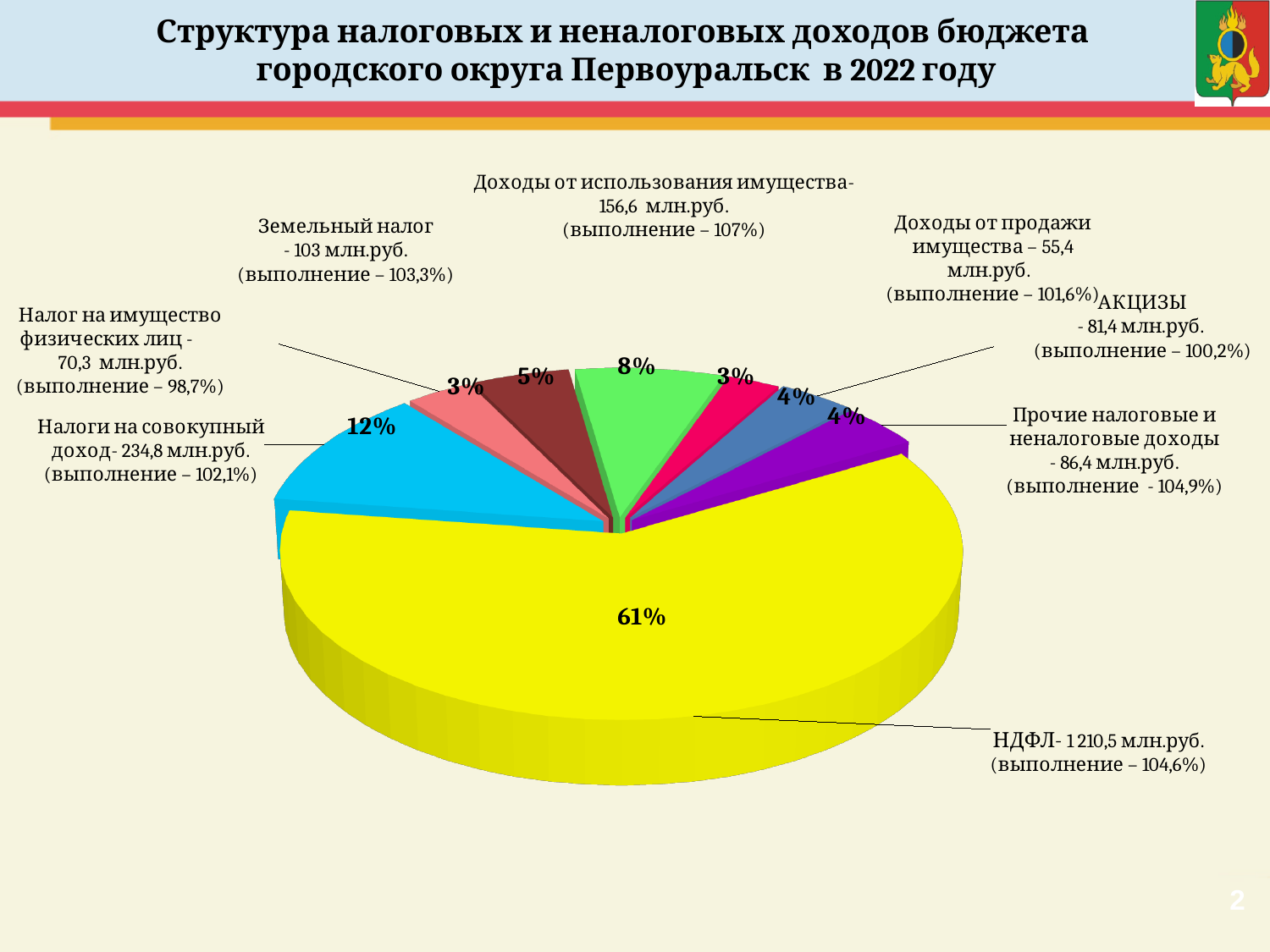
What type of chart is shown on the slide? pie chart By how many percentage points does the share of НДФЛ exceed the share of Налоги на совокупный доход? 49 percentage points What выполнение percentage is shown for Доходы от использования имущества? 107% What share of the pie does Налоги на совокупный доход account for? 12% What is the value in млн.руб. shown for НДФЛ? 1 210,5 млн.руб. What share of the pie does Доходы от использования имущества account for? 8% What share of the pie does Земельный налог account for? 5% Which has the larger share of the pie: Земельный налог or Доходы от использования имущества? Доходы от использования имущества Which category has the largest slice of the pie? НДФЛ What is the value in млн.руб. shown for АКЦИЗЫ? 81,4 млн.руб. What is the value in млн.руб. shown for Налог на имущество физических лиц? 70,3 млн.руб.